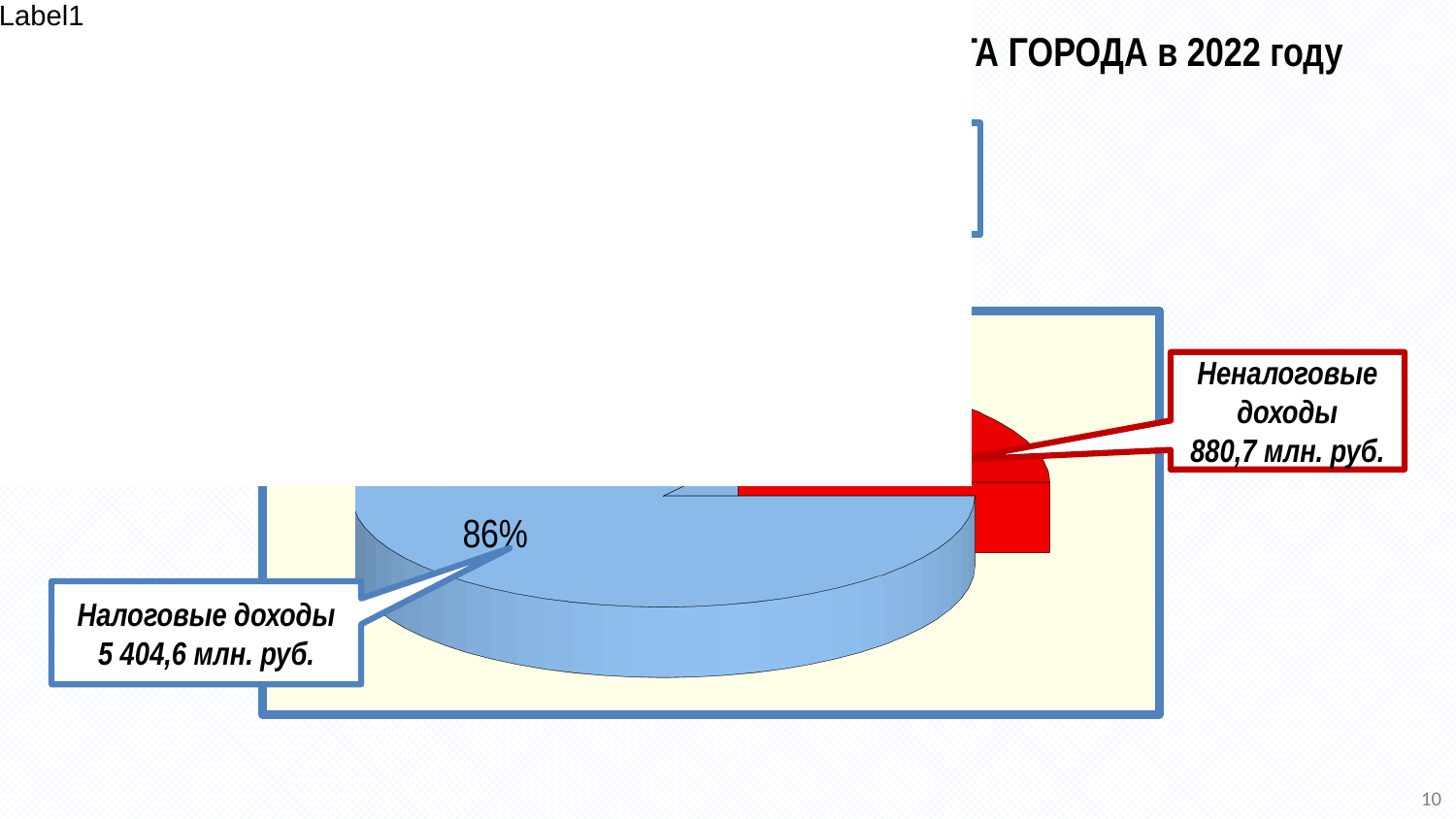
What colour is the slice for Неналоговые доходы? red What is the total of Налоговые доходы and Неналоговые доходы? 6 285,3 млн. руб. What share of the pie does Налоговые доходы take? 86% What kind of chart is shown on the slide? pie chart Which is larger, Налоговые доходы or Неналоговые доходы? Налоговые доходы What is the difference between Налоговые доходы and Неналоговые доходы? 4 523,9 млн. руб. What is the value shown for Налоговые доходы? 5 404,6 млн. руб. Which category has the smallest slice of the pie? Неналоговые доходы How many categories are shown in the pie chart? 2 What colour is the slice for Налоговые доходы? blue Which category has the largest slice of the pie? Налоговые доходы What is the value shown for Неналоговые доходы? 880,7 млн. руб.